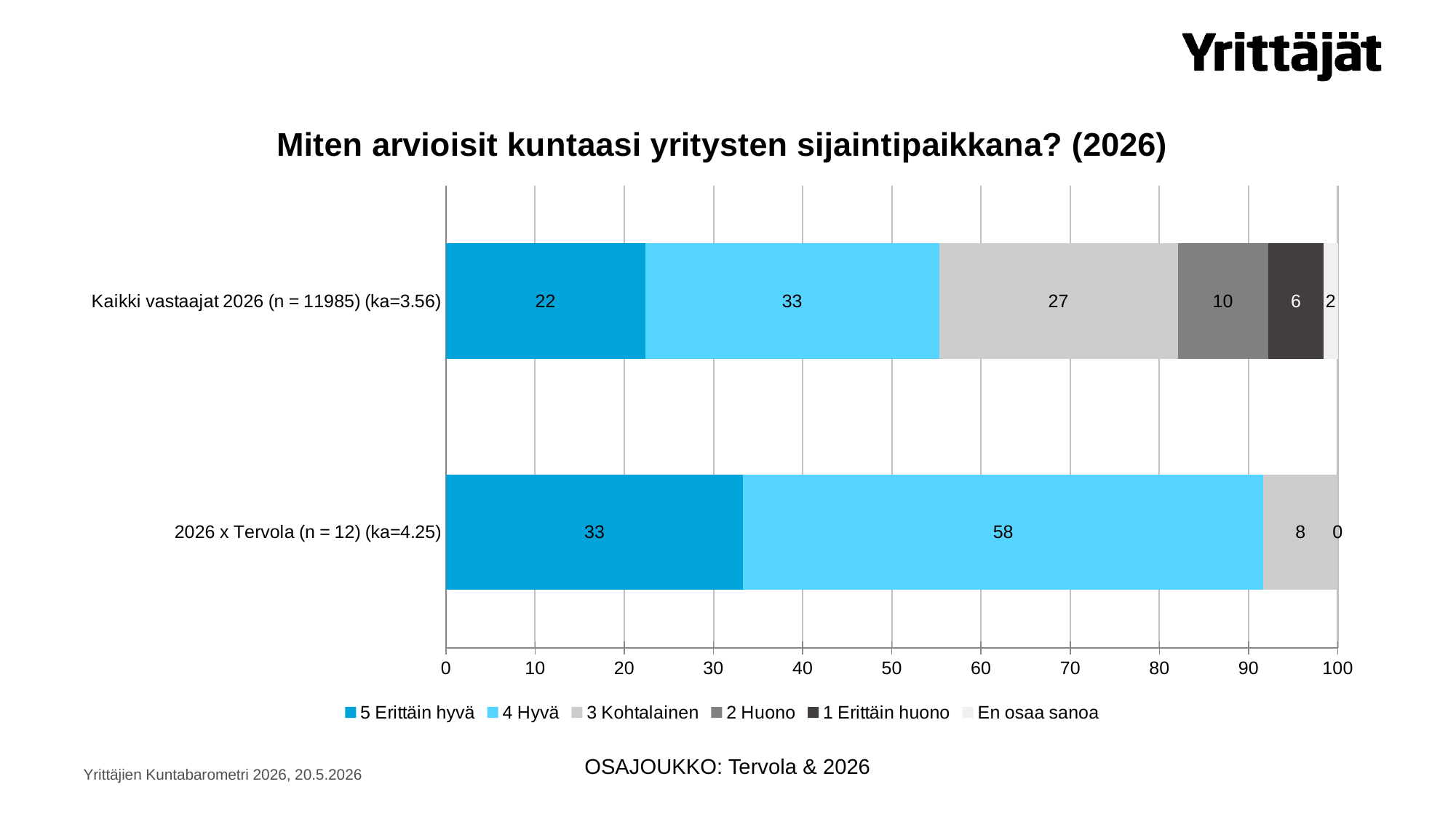
What is the value of "3 Kohtalainen" for "Kaikki vastaajat 2026 (n = 11985) (ka=3.56)"? 27 What is the difference between the "5 Erittäin hyvä" values for "2026 x Tervola" and "Kaikki vastaajat 2026"? 11 What kind of chart is shown on the slide? Stacked bar chart Which category has the higher value for "4 Hyvä": "Kaikki vastaajat 2026" or "2026 x Tervola"? 2026 x Tervola (n = 12) (ka=4.25) What is the value of "1 Erittäin huono" for "Kaikki vastaajat 2026 (n = 11985) (ka=3.56)"? 6 What is the value of "3 Kohtalainen" for "2026 x Tervola (n = 12) (ka=4.25)"? 8 What is the value of "2 Huono" for "Kaikki vastaajat 2026 (n = 11985) (ka=3.56)"? 10 What is the value of "4 Hyvä" for "2026 x Tervola (n = 12) (ka=4.25)"? 58 What is the value of "5 Erittäin hyvä" for "Kaikki vastaajat 2026 (n = 11985) (ka=3.56)"? 22 How many categories (bars) are plotted in the chart? 2 How many series does the legend list? 6 What is the title of the chart? Miten arvioisit kuntaasi yritysten sijaintipaikkana? (2026)